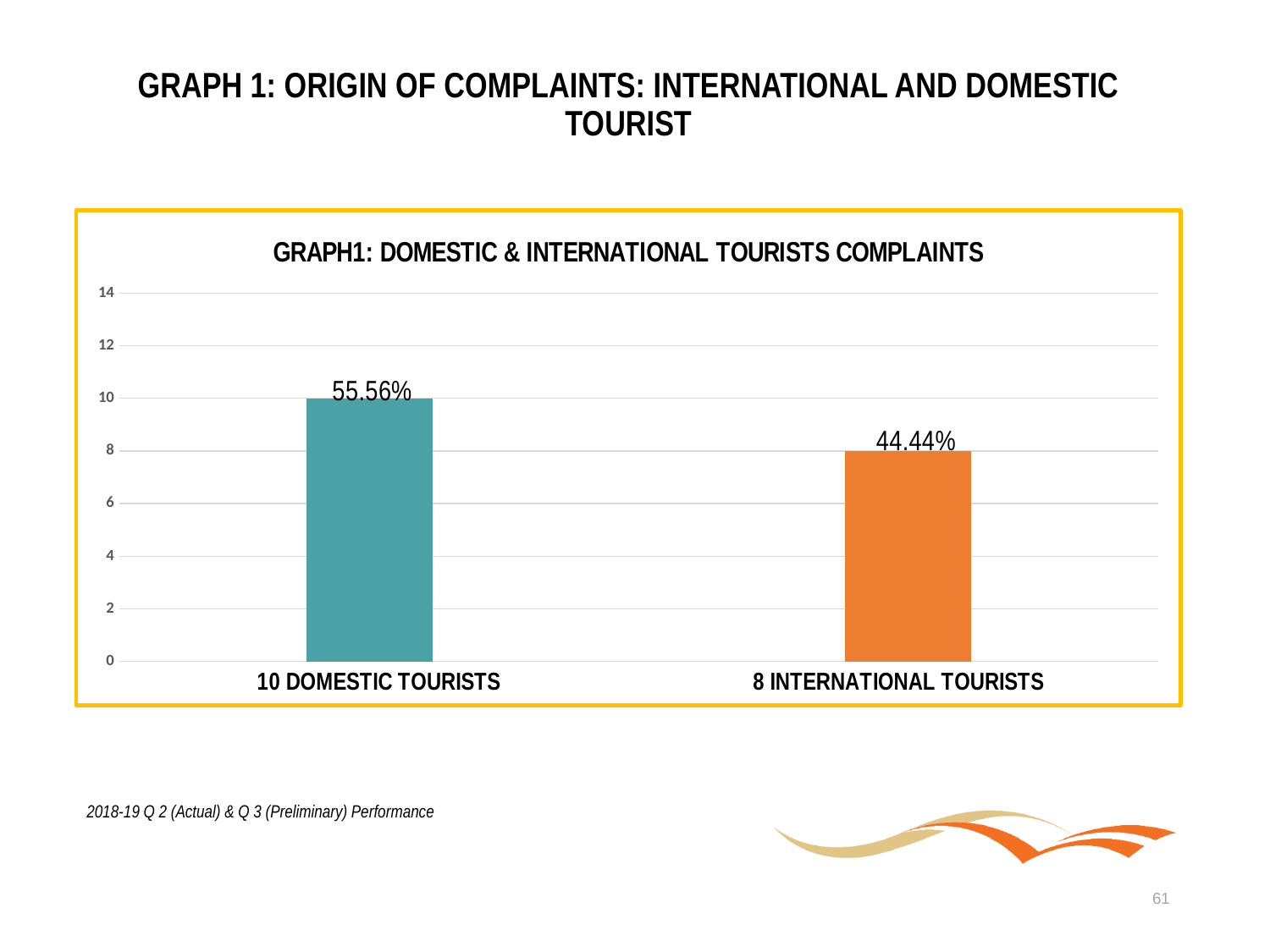
Which category has the lowest bar? 8 INTERNATIONAL TOURISTS What value on the vertical axis does the bar for 10 DOMESTIC TOURISTS reach? 10 What is the difference between the percentage labels for domestic tourists and international tourists? 11.12% What value on the vertical axis does the bar for 8 INTERNATIONAL TOURISTS reach? 8 How many categories are plotted in the chart? 2 What percentage label is shown on the bar for 8 INTERNATIONAL TOURISTS? 44.44% Is the value for 8 INTERNATIONAL TOURISTS greater or less than 12? less Which is larger, the value for domestic tourists or the value for international tourists? Domestic tourists By how much does the domestic tourists bar exceed the international tourists bar on the vertical axis? 2 What percentage label is shown on the bar for 10 DOMESTIC TOURISTS? 55.56% What type of chart is shown on the slide? Bar chart Which category has the highest bar? 10 DOMESTIC TOURISTS